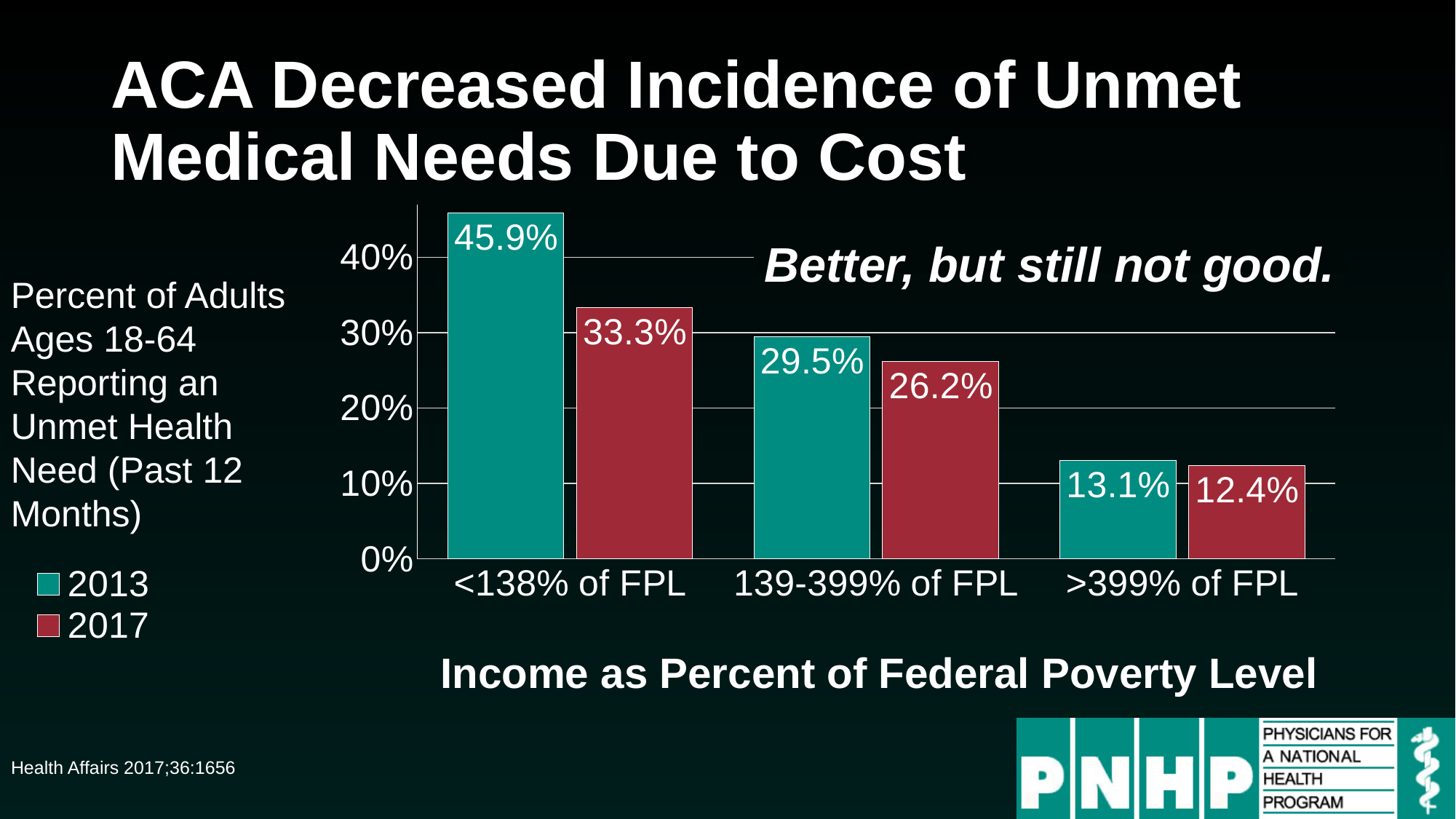
Which is larger, the 2013 value for 139-399% of FPL or the 2017 value for <138% of FPL? 2017 value for <138% of FPL What kind of chart is shown on the slide? bar chart What is the difference between the 2013 and 2017 values for 139-399% of FPL? 3.3% Which income category has the lowest 2017 value? >399% of FPL Which income category has the highest 2013 value? <138% of FPL What is the 2017 value for 139-399% of FPL? 26.2% Do the 2017 values rise or fall as income moves from <138% of FPL to >399% of FPL? fall How many series does the legend list? 2 What is the difference between the 2013 and 2017 values for <138% of FPL? 12.6% How many income categories are shown on the x axis? 3 What is the 2013 value for <138% of FPL? 45.9% What is the 2017 value for >399% of FPL? 12.4%